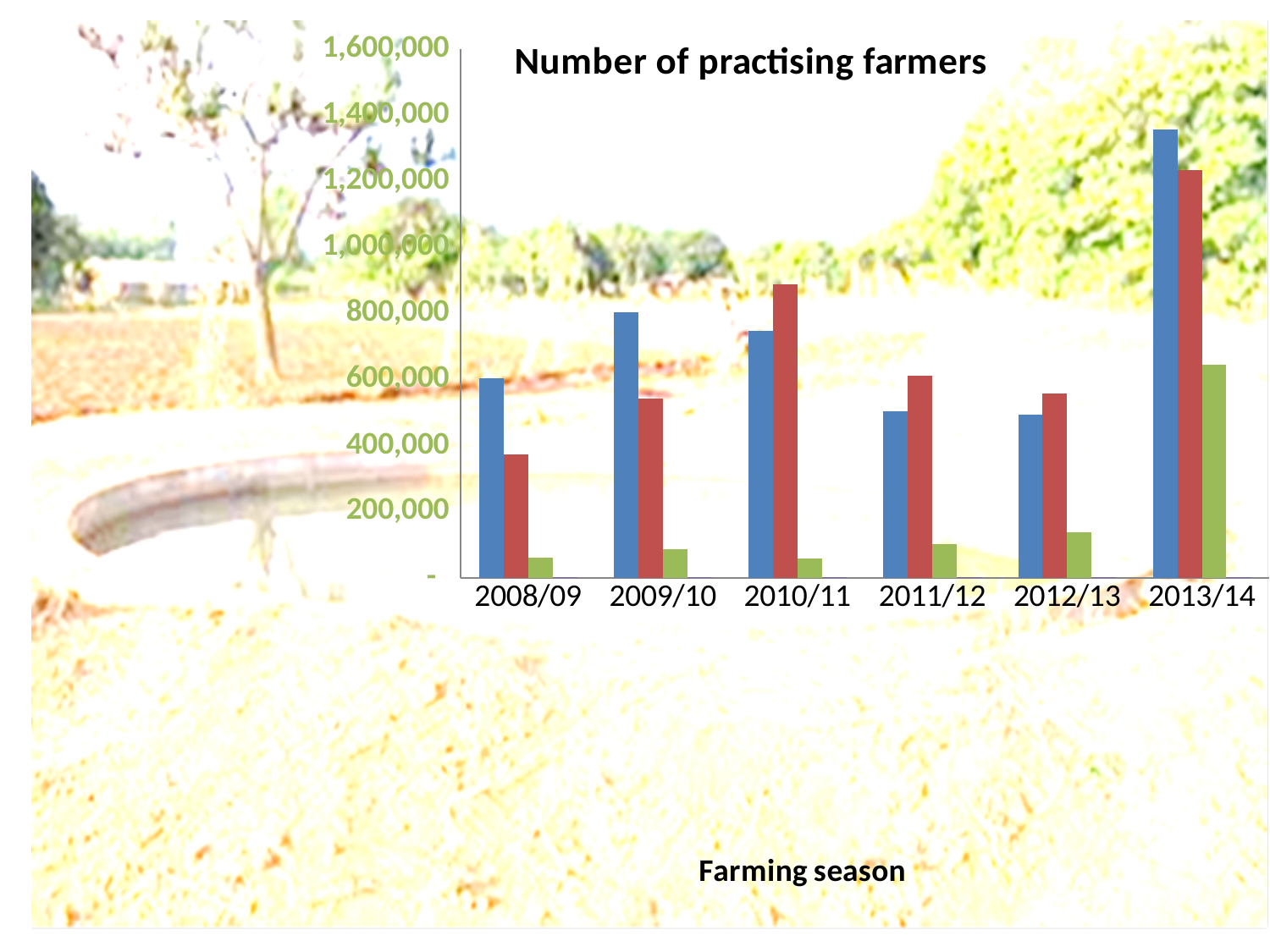
In 2010/11, which is larger, the blue bar or the red bar? the red bar In which farming season is the green bar highest? 2013/14 Is the value of the red bar for 2010/11 greater or less than 800,000? greater In which farming season is the red bar highest? 2013/14 Is the value of the green bar for 2013/14 greater or less than 400,000? greater Is the value of the blue bar for 2013/14 greater or less than 1,200,000? greater What is the title of the chart? Number of practising farmers What kind of chart is shown on the slide? bar chart How many farming seasons are shown on the x axis? 6 In which farming season is the red bar lowest? 2008/09 What is the label on the x axis of the chart? Farming season In which farming season is the blue bar highest? 2013/14